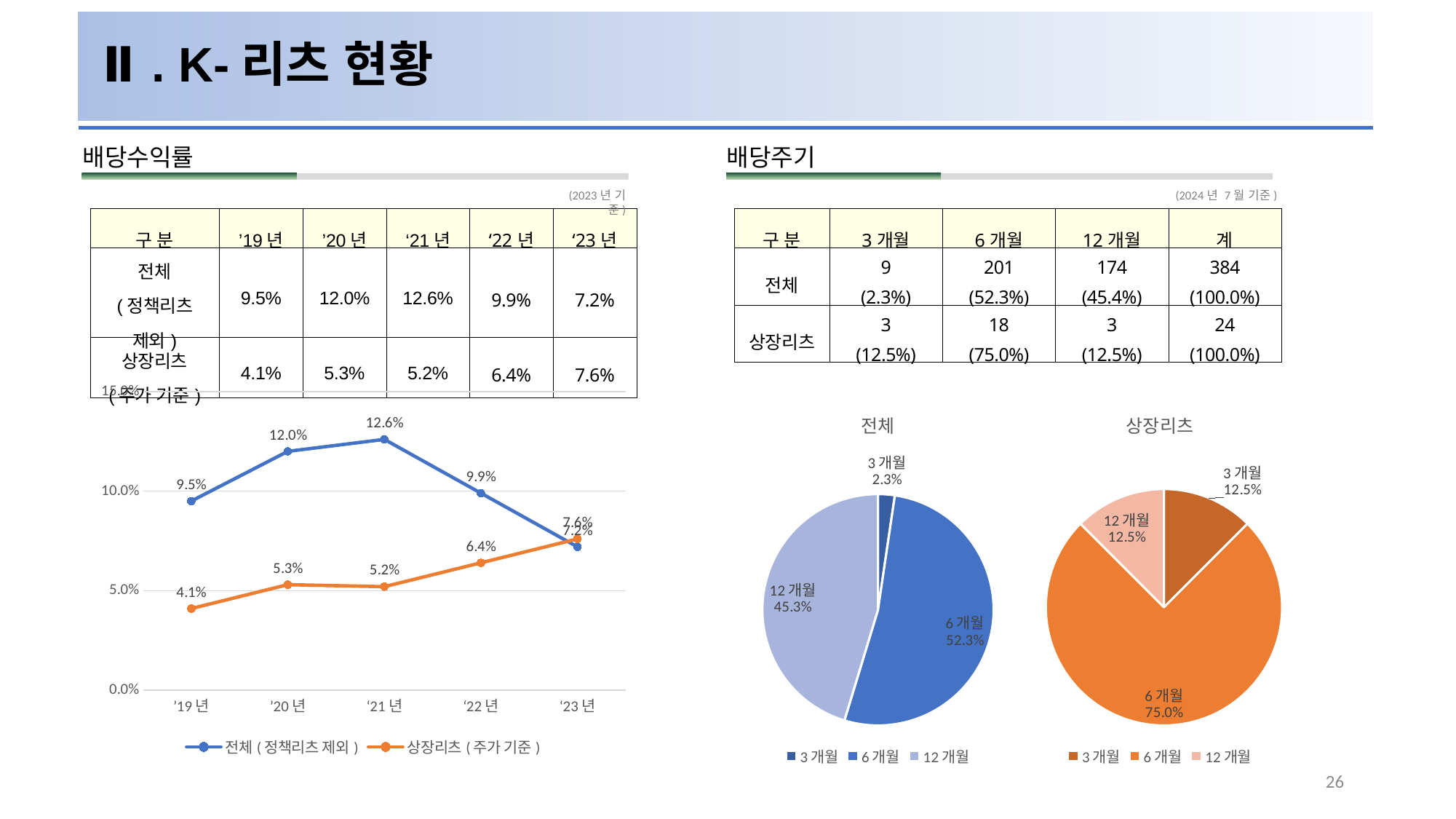
In the 배당수익률 line chart, which series has the higher value in '23년? 상장리츠 (주가 기준) In the 배당수익률 line chart, in which year is 전체 (정책리츠 제외) highest? '21년 In the 배당수익률 line chart, how many years are shown on the x axis? 5 In the 전체 pie chart, what share does 6개월 have? 52.3% In the 배당수익률 line chart, what is the value for 상장리츠 (주가 기준) in '19년? 4.1% In the 배당수익률 line chart, what is the value for 전체 (정책리츠 제외) in '21년? 12.6% In the 배당수익률 line chart, in which year is 상장리츠 (주가 기준) lowest? '19년 In the 배당수익률 line chart, what is the difference between 전체 (정책리츠 제외) and 상장리츠 (주가 기준) in '20년? 6.7 percentage points In the 배당수익률 line chart, how many series does the legend list? 2 In the 상장리츠 pie chart, which slice is the largest? 6개월 In the 배당수익률 line chart, does 전체 (정책리츠 제외) rise or fall from '21년 to '23년? Fall What kind of chart is the 배당수익률 chart on the left? Line chart